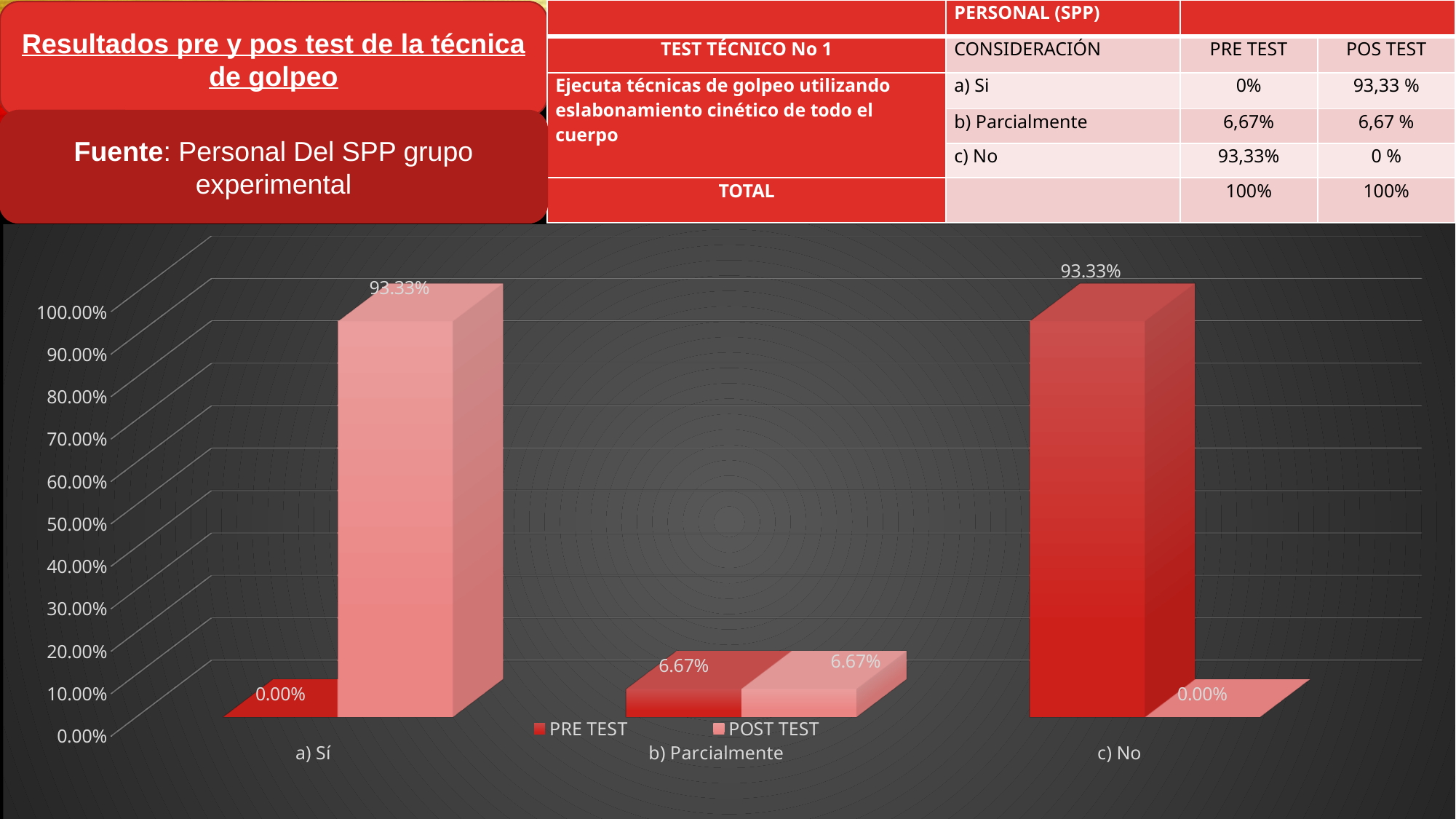
Which is larger for c) No, the PRE TEST value or the POST TEST value? PRE TEST What is the difference between the POST TEST and PRE TEST values for a) Sí? 93.33% How many categories are shown on the x axis? 3 What kind of chart is shown on the slide? Bar chart How many series does the legend list? 2 What is the POST TEST value for a) Sí? 93.33% What is the POST TEST value for c) No? 0.00% Which category has the lowest POST TEST value? c) No What is the PRE TEST value for b) Parcialmente? 6.67% What are the two series named in the legend? PRE TEST and POST TEST What is the PRE TEST value for c) No? 93.33% Which category has the highest PRE TEST value? c) No